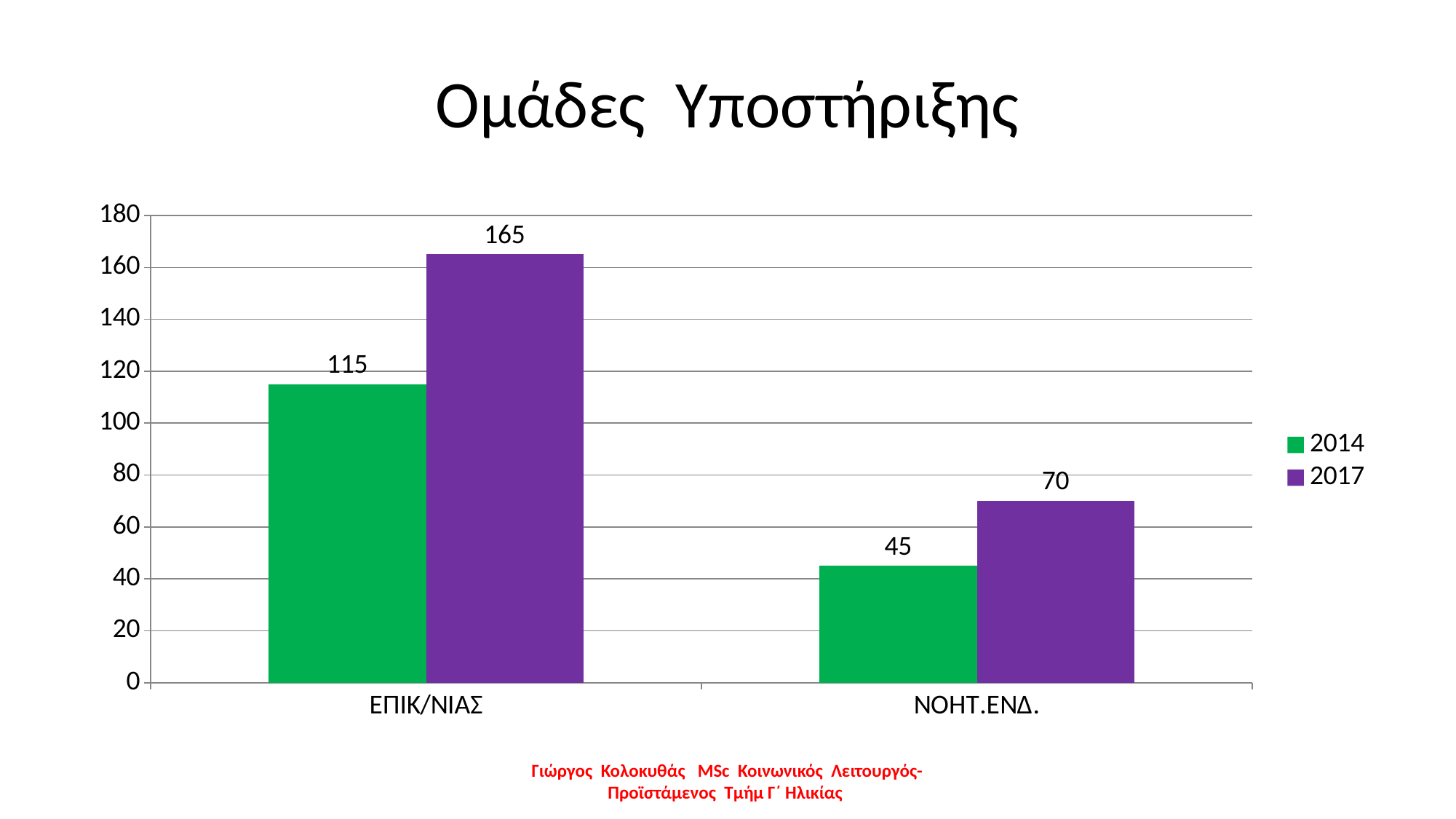
How many categories are shown on the x axis? 2 What kind of chart is shown on the slide? Bar chart What is the value for ΝΟΗΤ.ΕΝΔ. in 2017? 70 What is the value for ΝΟΗΤ.ΕΝΔ. in 2014? 45 Which category has the lowest value in 2014? ΝΟΗΤ.ΕΝΔ. Which category has the highest value in 2017? ΕΠΙΚ/ΝΙΑΣ What is the value for ΕΠΙΚ/ΝΙΑΣ in 2017? 165 What is the difference between the 2017 and 2014 values for ΝΟΗΤ.ΕΝΔ.? 25 What is the value for ΕΠΙΚ/ΝΙΑΣ in 2014? 115 Which is larger for ΝΟΗΤ.ΕΝΔ., the 2014 value or the 2017 value? 2017 How many series does the legend list? 2 What is the difference between the 2017 and 2014 values for ΕΠΙΚ/ΝΙΑΣ? 50